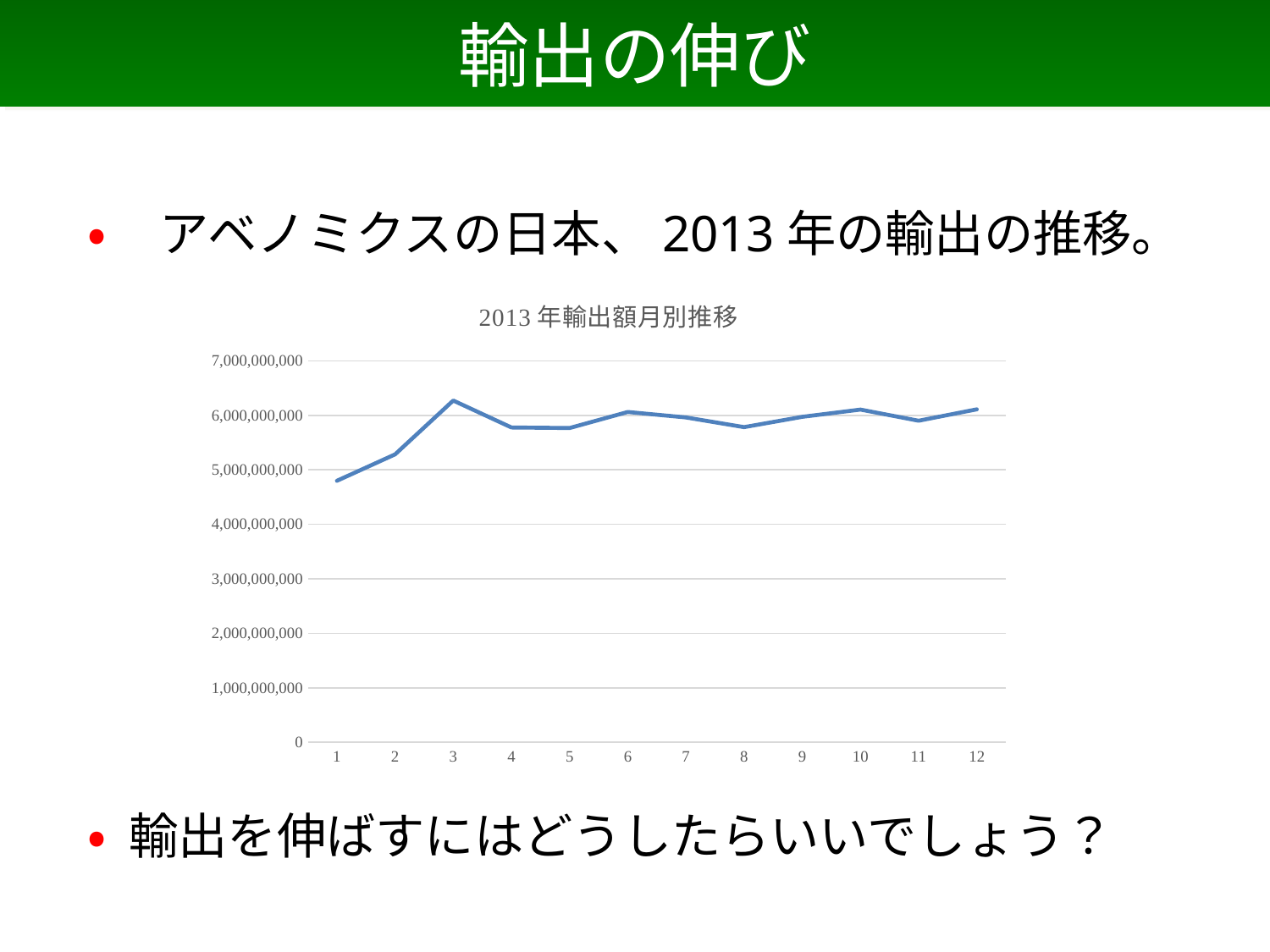
Which month (x-axis category) has the highest value in the chart? 3 Which is larger, the value for month 1 or the value for month 3? month 3 Which month (x-axis category) has the lowest value in the chart? 1 What kind of chart is shown on the slide? line chart How many data points are plotted along the x axis of the chart? 12 Is the value for month 4 greater or less than 6,000,000,000? less What is the title of the chart? 2013年輸出額月別推移 Is the value for month 2 greater or less than 5,000,000,000? greater Is the value for month 1 greater or less than 5,000,000,000? less What is the highest tick value shown on the y axis of the chart? 7,000,000,000 Do the values rise or fall from month 1 to month 3? rise